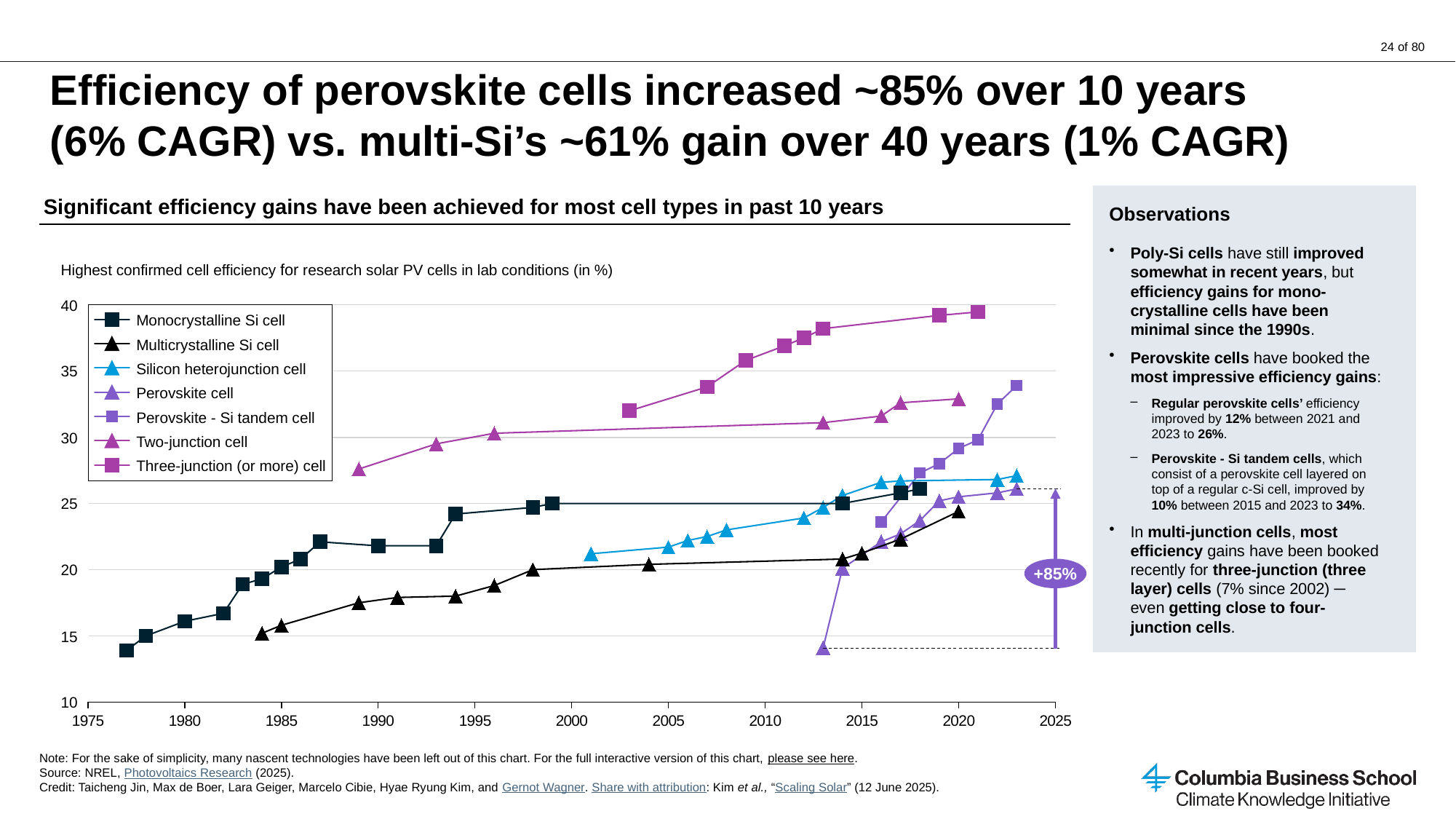
How many series does the chart legend list? 7 Is the value for the Silicon heterojunction cell in 2023 greater or less than 25? greater In 2023, which is higher: the Perovskite - Si tandem cell or the Perovskite cell? Perovskite - Si tandem cell Do the efficiency values for the Perovskite cell rise or fall over time? rise What percentage gain is shown by the annotation arrow on the right side of the chart? +85% Which series reaches the highest efficiency value on the chart? Three-junction (or more) cell In 2020, which is higher: the Three-junction (or more) cell or the Two-junction cell? Three-junction (or more) cell Which series has the lowest plotted value on the chart? Monocrystalline Si cell Is the value for the Three-junction (or more) cell in 2021 greater or less than 35? greater Is the value for the Perovskite - Si tandem cell in 2023 greater or less than 30? greater What kind of chart is shown on the slide? line chart